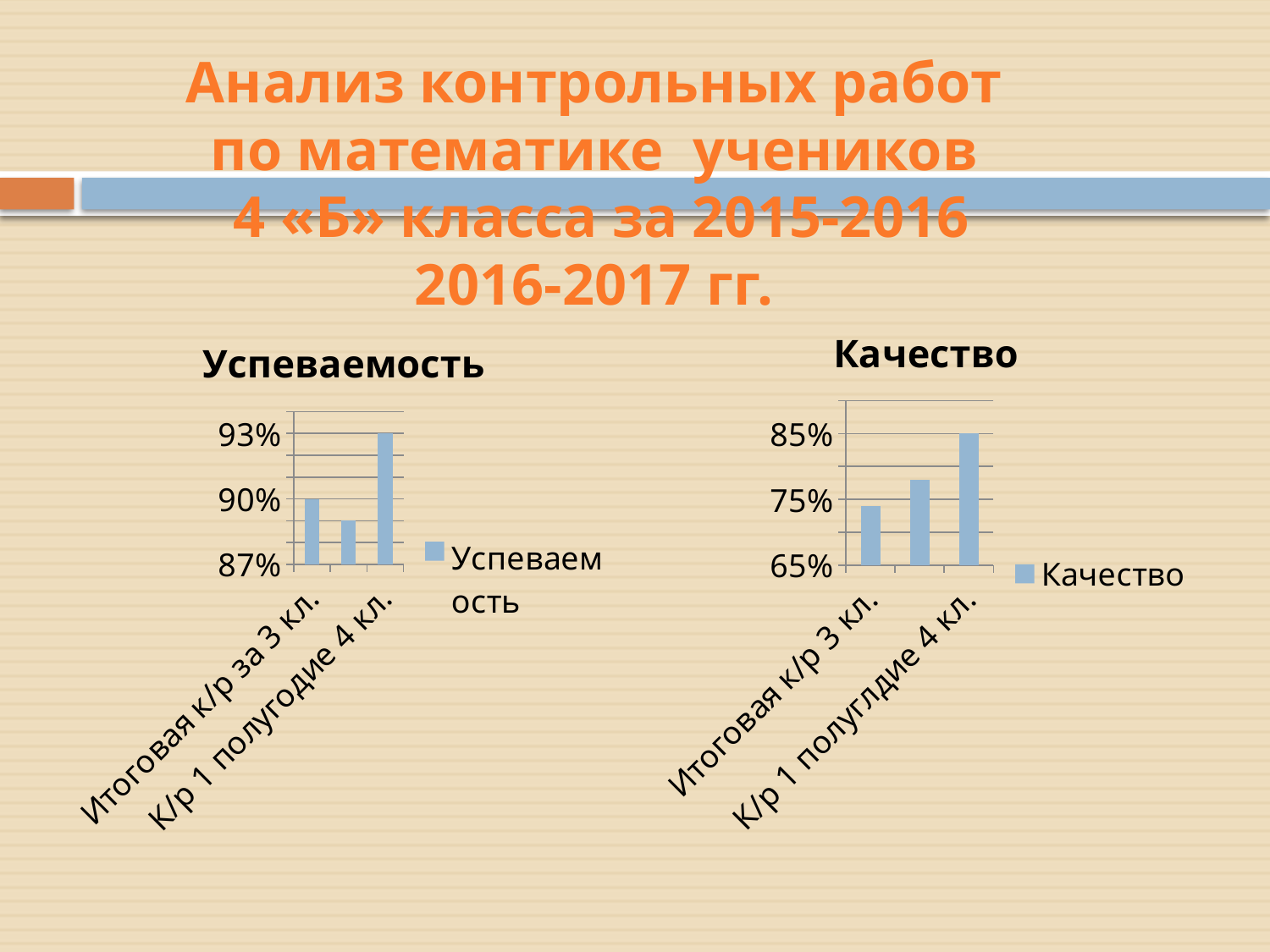
In the "Качество" chart, is the value for "К/р 1 полугдие 4 кл." greater or less than 75%? greater In the "Качество" chart, do the values rise or fall from left to right? rise How many series does the legend of the "Качество" chart list? 1 In the "Качество" chart, is the value for "Итоговая к/р 3 кл." greater or less than 75%? less In the "Качество" chart, which is larger: "Итоговая к/р 3 кл." or "К/р 1 полугдие 4 кл."? К/р 1 полугдие 4 кл. How many bars are plotted in the "Качество" chart? 3 What kind of chart is the "Успеваемость" chart? bar chart In the "Успеваемость" chart, what is the value for "Итоговая к/р за 3 кл."? 90% What is the legend entry of the "Успеваемость" chart? Успеваемость In the "Успеваемость" chart, is the value for "К/р 1 полугодие 4 кл." greater or less than 90%? greater How many bars are plotted in the "Успеваемость" chart? 3 What kind of chart is the "Качество" chart? bar chart